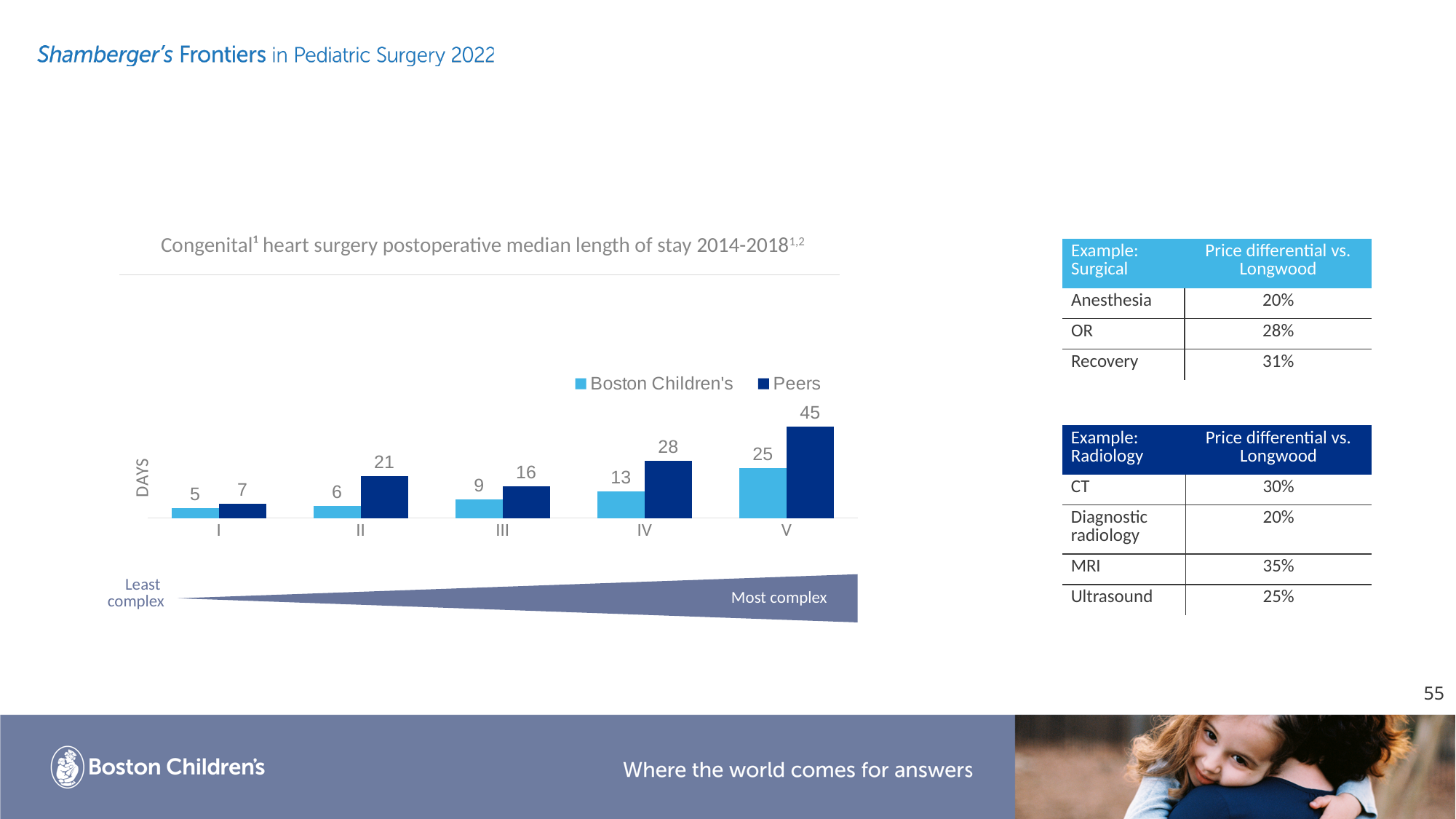
How many series does the chart legend list? 2 Which category has the lowest value for Boston Children's? I Which category has the highest value for Peers? V What is the difference between Peers and Boston Children's in category II? 15 What is the difference between Peers and Boston Children's in category V? 20 How many categories are shown on the x axis of the chart? 5 What is the value for Boston Children's in category I? 5 What is the median length of stay for Boston Children's in category V? 25 What is the median length of stay for Peers in category III? 16 In category IV, which series has the larger value, Boston Children's or Peers? Peers What kind of chart is shown on the slide? Bar chart